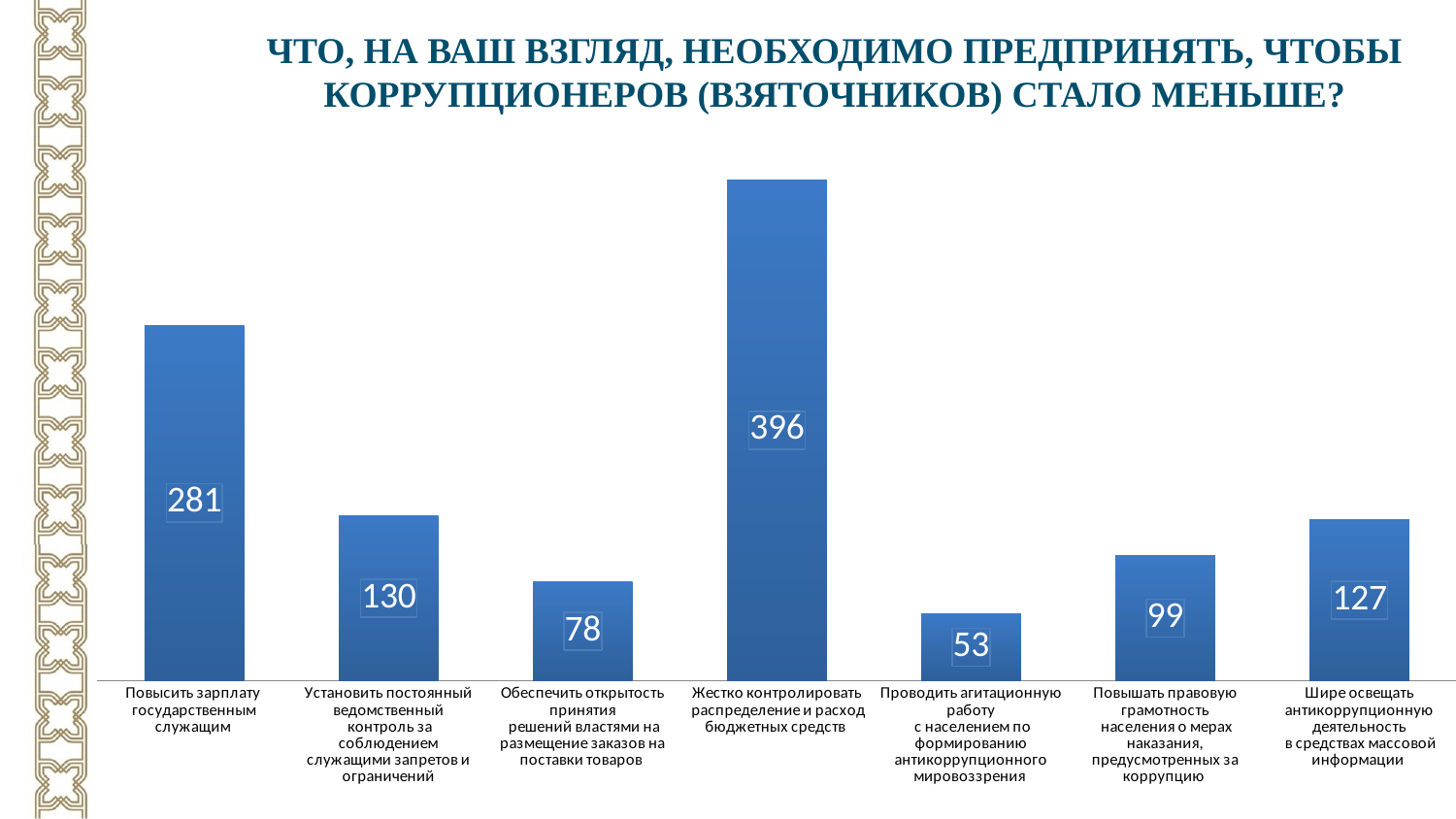
How many categories are shown in the chart? 7 What value is shown for "Жестко контролировать распределение и расход бюджетных средств"? 396 What is the title of the chart? ЧТО, НА ВАШ ВЗГЛЯД, НЕОБХОДИМО ПРЕДПРИНЯТЬ, ЧТОБЫ КОРРУПЦИОНЕРОВ (ВЗЯТОЧНИКОВ) СТАЛО МЕНЬШЕ? What value is shown for "Шире освещать антикоррупционную деятельность в средствах массовой информации"? 127 Which category has the lowest value? Проводить агитационную работу с населением по формированию антикоррупционного мировоззрения What is the difference between the values for "Жестко контролировать распределение и расход бюджетных средств" and "Повысить зарплату государственным служащим"? 115 What kind of chart is shown on the slide? Bar chart Which category has the highest value? Жестко контролировать распределение и расход бюджетных средств What value is shown for "Обеспечить открытость принятия решений властями на размещение заказов на поставки товаров"? 78 Which is larger: the value for "Установить постоянный ведомственный контроль за соблюдением служащими запретов и ограничений" or for "Шире освещать антикоррупционную деятельность в средствах массовой информации"? Установить постоянный ведомственный контроль за соблюдением служащими запретов и ограничений What is the difference between the values for "Установить постоянный ведомственный контроль за соблюдением служащими запретов и ограничений" and "Повышать правовую грамотность населения о мерах наказания, предусмотренных за коррупцию"? 31 What value is shown for "Повысить зарплату государственным служащим"? 281